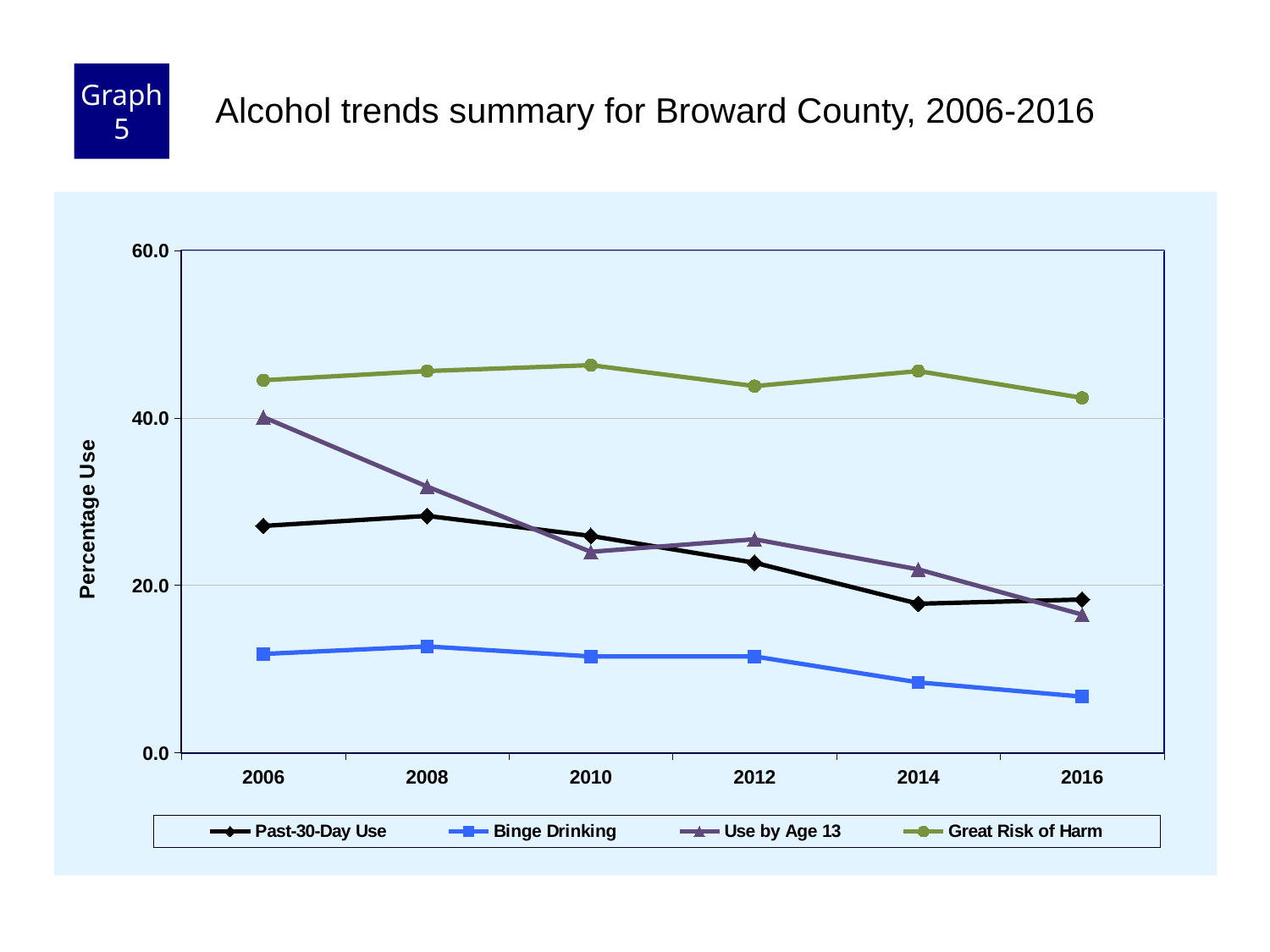
In 2006, which is larger: Use by Age 13 or Past-30-Day Use? Use by Age 13 Which series has the lowest value in 2006? Binge Drinking Does Use by Age 13 rise or fall overall from 2006 to 2016? Fall What kind of chart is shown on the slide? Line chart Is the value for Great Risk of Harm in 2010 greater or less than 40.0? greater Which series has the highest value in 2016? Great Risk of Harm How many years are plotted along the x axis? 6 What is the label on the y axis? Percentage Use In which year is Use by Age 13 at its highest? 2006 Is the value for Binge Drinking in 2008 greater or less than 20.0? less How many series does the legend list? 4 In which year is Binge Drinking at its lowest? 2016